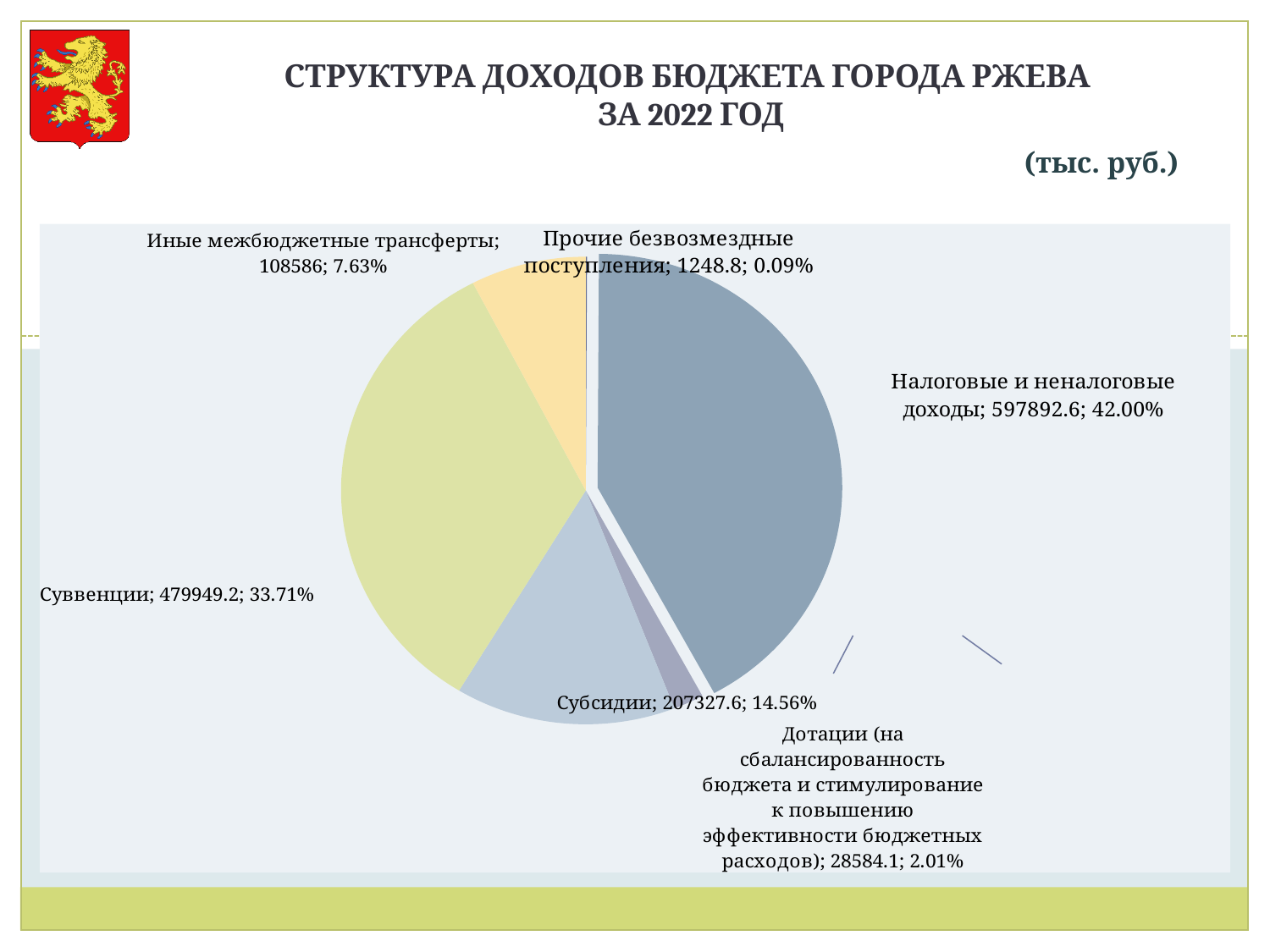
What is the title of the chart on the slide? СТРУКТУРА ДОХОДОВ БЮДЖЕТА ГОРОДА РЖЕВА ЗА 2022 ГОД Which is larger: Субсидии or Иные межбюджетные трансферты? Субсидии Which category has the smallest slice of the pie? Прочие безвозмездные поступления How many slices does the pie chart have? 6 Which category has the largest slice of the pie? Налоговые и неналоговые доходы What is the value for Дотации (на сбалансированность бюджета и стимулирование к повышению эффективности бюджетных расходов)? 28584.1 What percentage share is shown for Иные межбюджетные трансферты? 7.63% What is the value for Субсидии? 207327.6 What share of the pie does Субвенции represent? 33.71% What kind of chart is shown on the slide? pie chart What is the value for Налоговые и неналоговые доходы? 597892.6 What is the difference between the values for Налоговые и неналоговые доходы and Субвенции? 117943.4